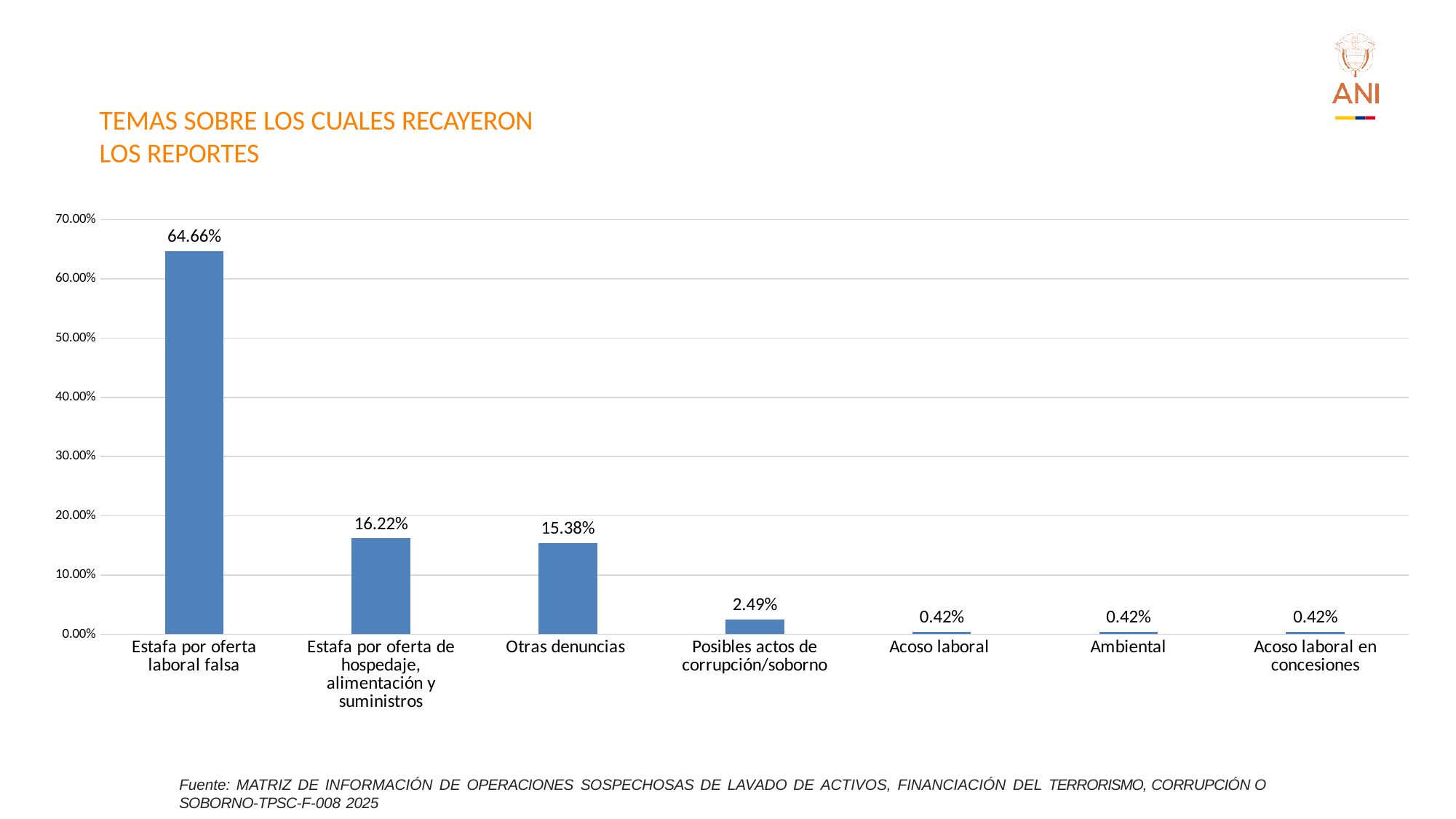
What is the value for Ambiental? 0.42% What is the title of the chart? TEMAS SOBRE LOS CUALES RECAYERON LOS REPORTES Which category has the highest value? Estafa por oferta laboral falsa Which is larger, Otras denuncias or Posibles actos de corrupción/soborno? Otras denuncias Is the value for Estafa por oferta laboral falsa greater or less than 60.00%? greater What is the value for Otras denuncias? 15.38% What kind of chart is shown on the slide? Bar chart What is the value for Posibles actos de corrupción/soborno? 2.49% How many categories are shown on the x axis? 7 What is the difference between Estafa por oferta laboral falsa and Estafa por oferta de hospedaje, alimentación y suministros? 48.44% What is the value for Estafa por oferta laboral falsa? 64.66% What is the difference between Estafa por oferta de hospedaje, alimentación y suministros and Otras denuncias? 0.84%